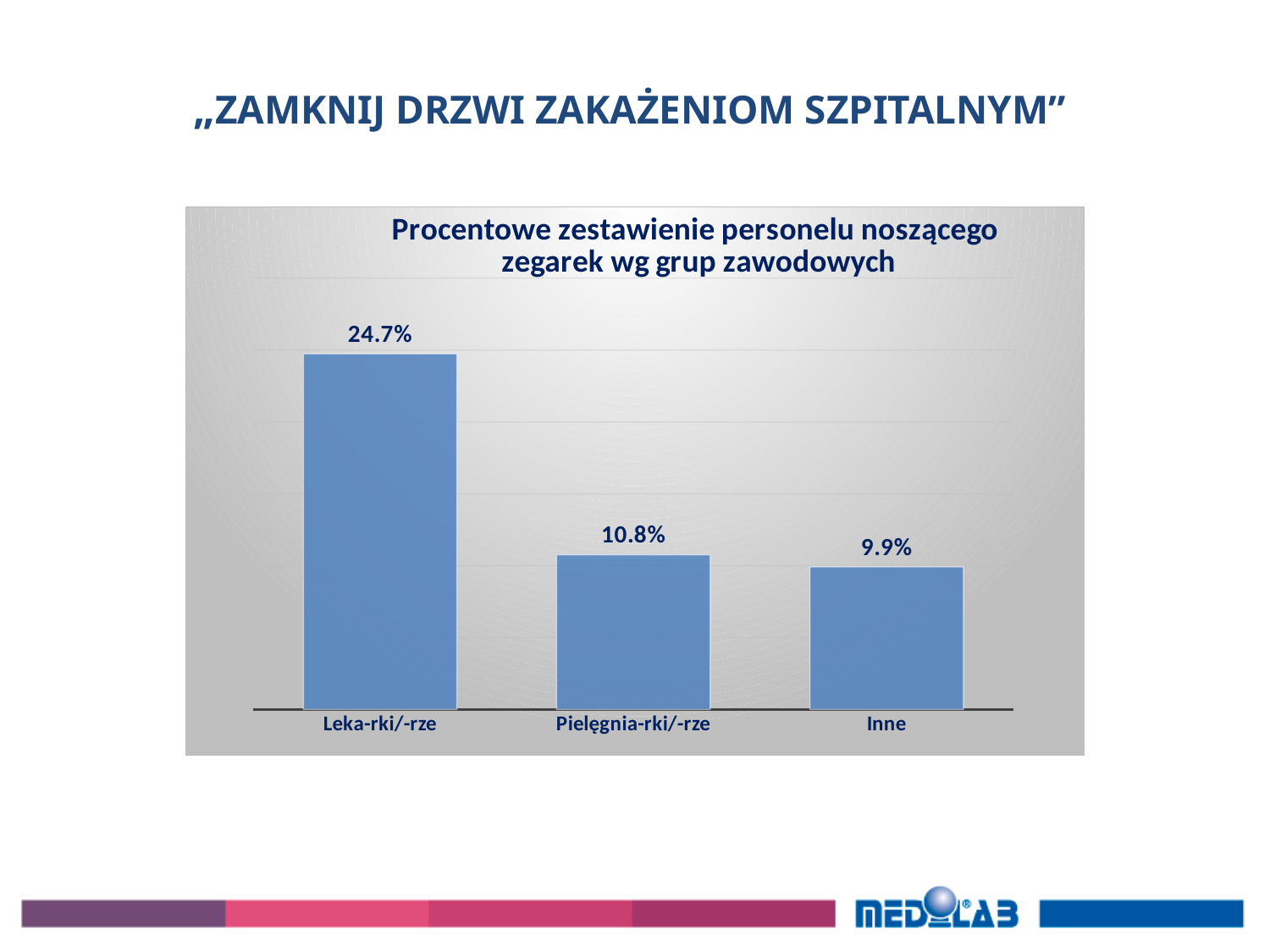
Which category has the highest value? Leka-rki/-rze Which category has the lowest value? Inne How many categories are shown in the chart? 3 What is the difference between the values for Leka-rki/-rze and Pielęgnia-rki/-rze? 13.9% What is the value for Inne? 9.9% What is the difference between the values for Pielęgnia-rki/-rze and Inne? 0.9% What is the value for Pielęgnia-rki/-rze? 10.8% What kind of chart is shown on the slide? Bar chart Which is larger, the value for Leka-rki/-rze or the value for Inne? Leka-rki/-rze Do the values rise or fall from left to right across the categories? Fall What is the value for Leka-rki/-rze? 24.7% What is the title of the chart? Procentowe zestawienie personelu noszącego zegarek wg grup zawodowych